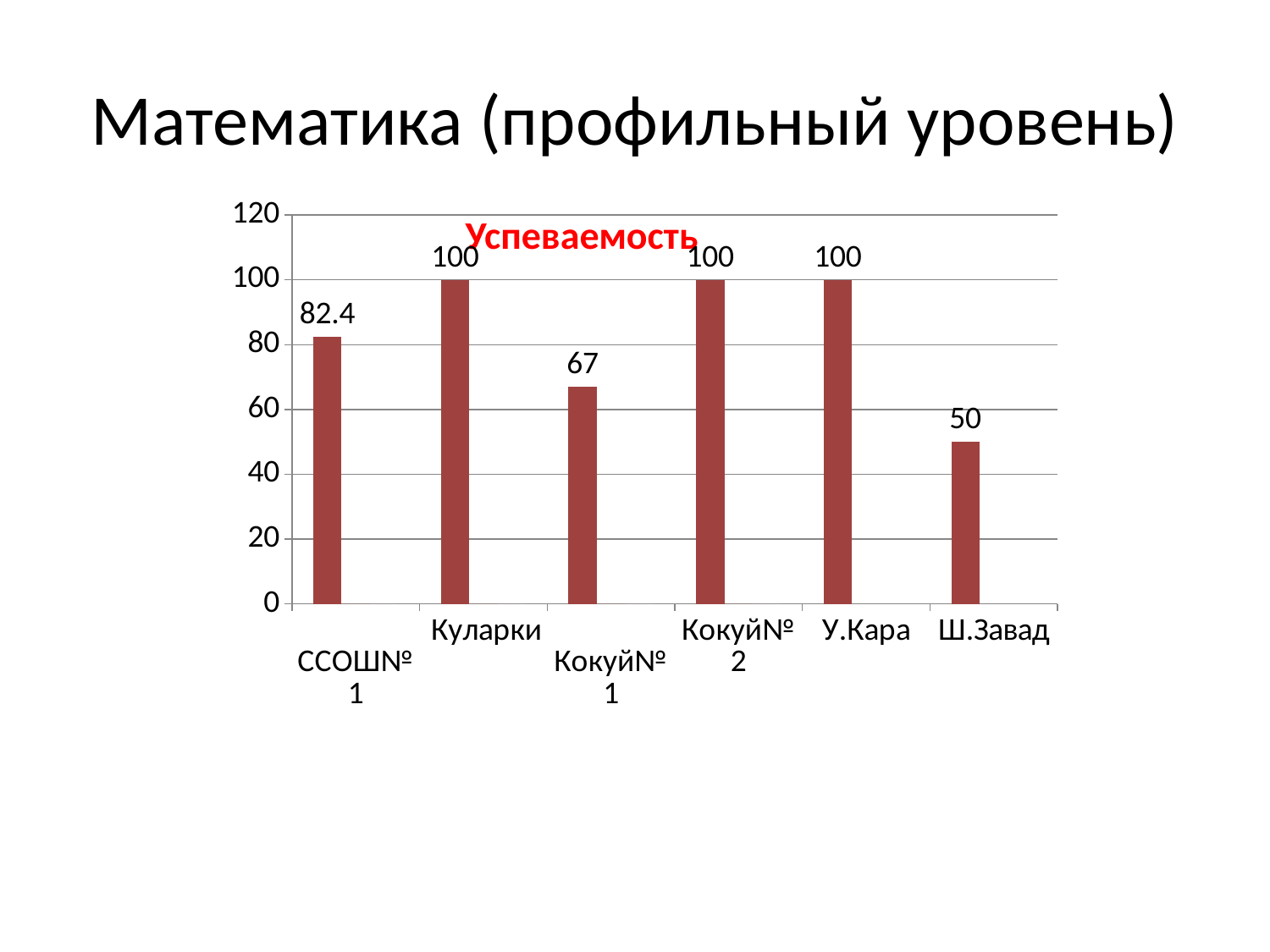
What is the title of the chart? Успеваемость What is the value for Ш.Завад? 50 What is the difference between the values for ССОШ№1 and Ш.Завад? 32.4 What kind of chart is shown on the slide? bar chart How many categories have a value of 100? 3 What is the value for У.Кара? 100 What is the difference between the values for Куларки and Кокуй№1? 33 How many categories are shown on the x axis? 6 What is the value for Кокуй№1? 67 Which category has the lowest value? Ш.Завад Which is larger, the value for ССОШ№1 or the value for Кокуй№1? ССОШ№1 What is the value for ССОШ№1? 82.4